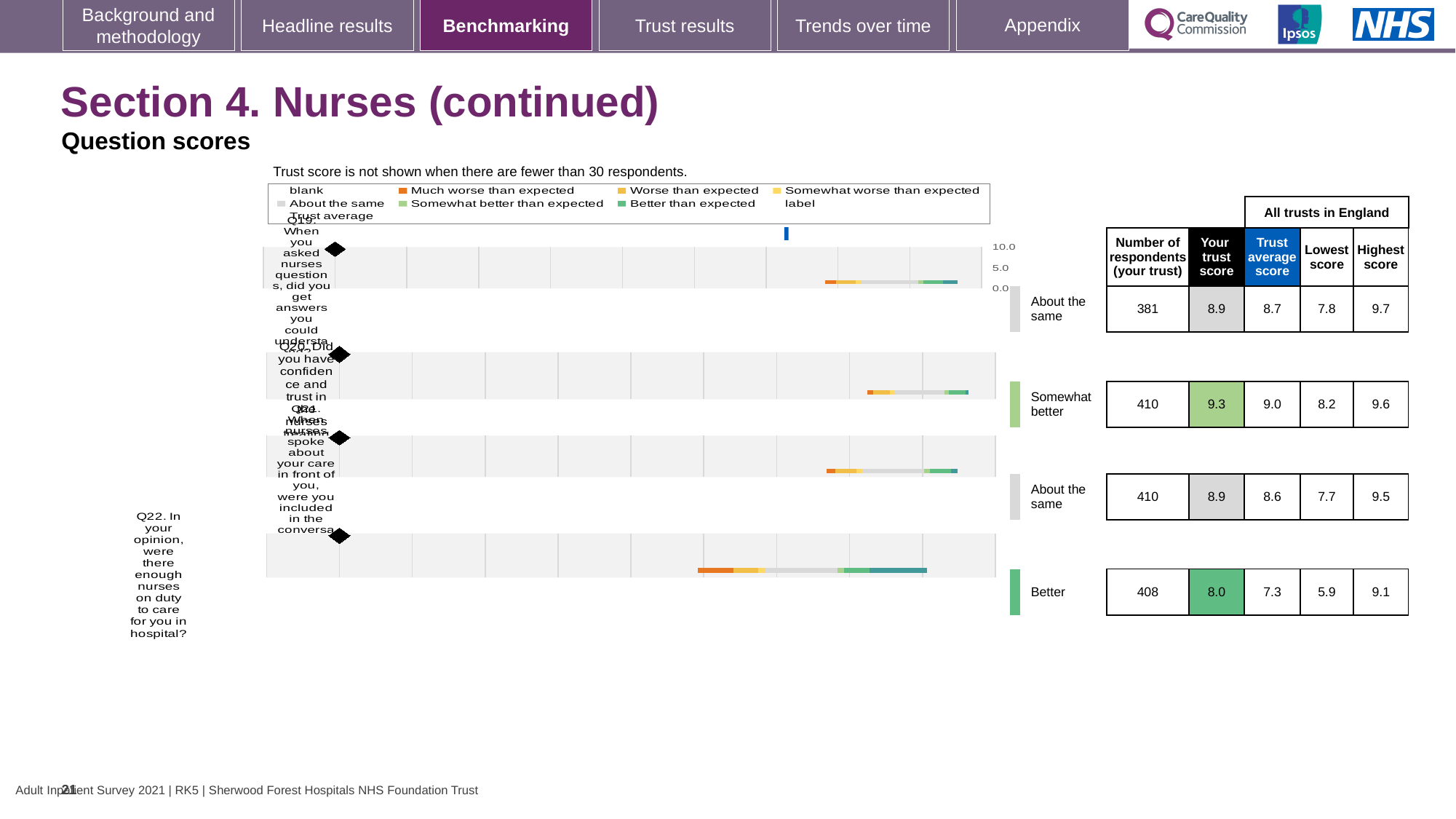
What is the lowest score across all trusts in England for Q21? 7.7 What is the highest score across all trusts in England for Q22? 9.1 How many questions are plotted in the benchmarking chart on this slide? 4 What kind of chart is used to show the question scores on this slide? Bar chart What benchmarking category is shown for Q20 (confidence and trust in the nurses)? Somewhat better What is the trust average score for Q20 (did you have confidence and trust in the nurses)? 9.0 What is the 'Your trust score' for Q22 (were there enough nurses on duty to care for you in hospital)? 8.0 Which question has the highest 'Your trust score' on this slide? Q20 How many respondents from your trust answered Q19 (did you get answers you could understand)? 381 For Q22, what is the difference between your trust score and the trust average score? 0.7 Which question has the lowest 'Your trust score' on this slide? Q22 For Q19, which is larger: your trust score or the trust average score? Your trust score